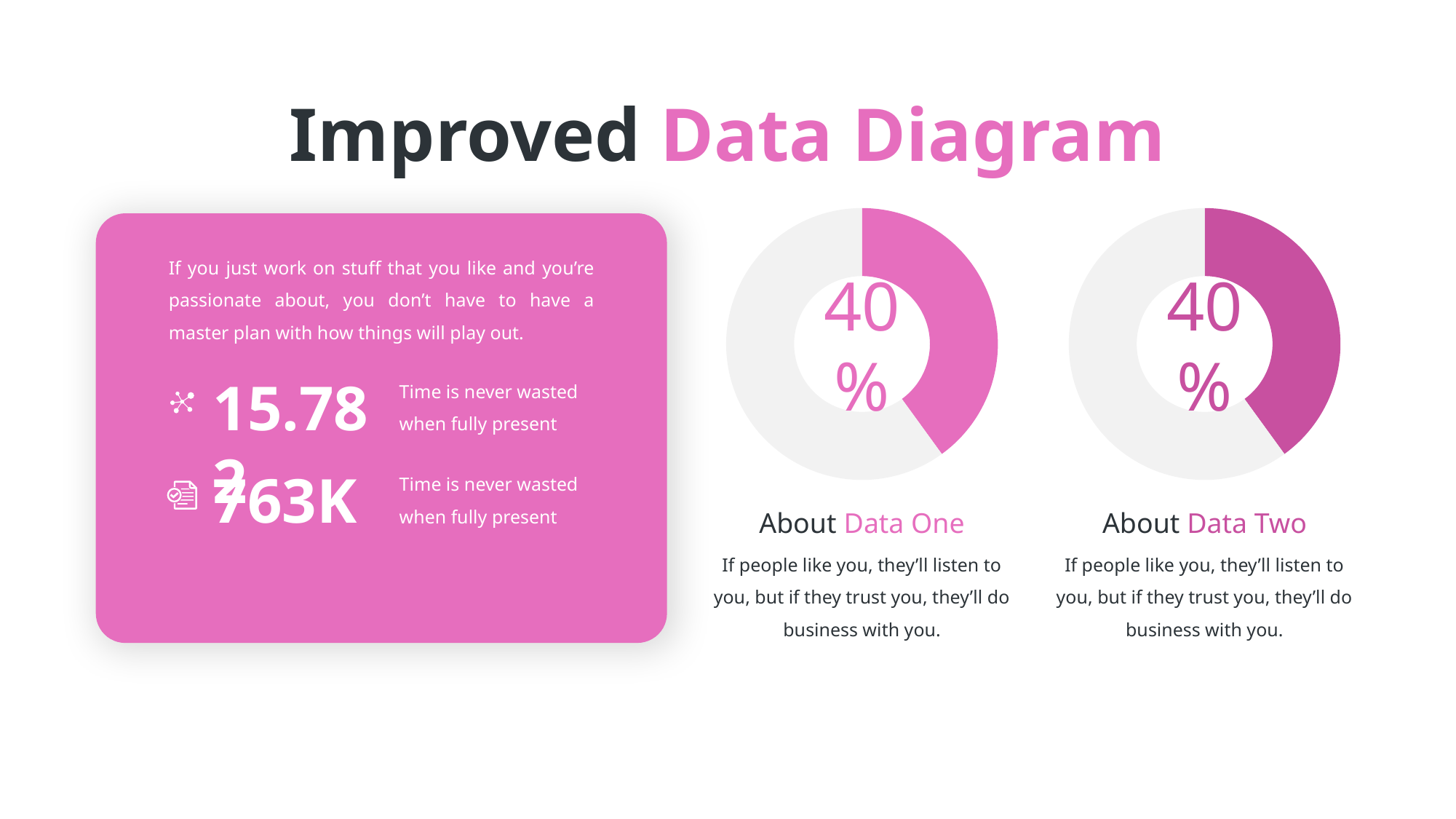
Which donut chart shows the larger percentage, Data One or Data Two? They are equal (both 40%) How many donut charts are shown on the slide? 2 Which donut chart uses the darker magenta colour for its filled segment, Data One or Data Two? Data Two What is the label printed below the left donut chart? About Data One Is the value shown in the About Data Two donut chart greater or less than 50%? less In the donut chart labelled About Data One, what percentage is printed in the centre? 40% How many segments does each donut chart have? 2 What is the difference between the percentage shown for Data One and the percentage shown for Data Two? 0% What kind of chart is used for Data One and Data Two? Doughnut chart In the About Data One donut chart, what share of the ring is filled with pink? 40% In the donut chart labelled About Data Two, what percentage is printed in the centre? 40%